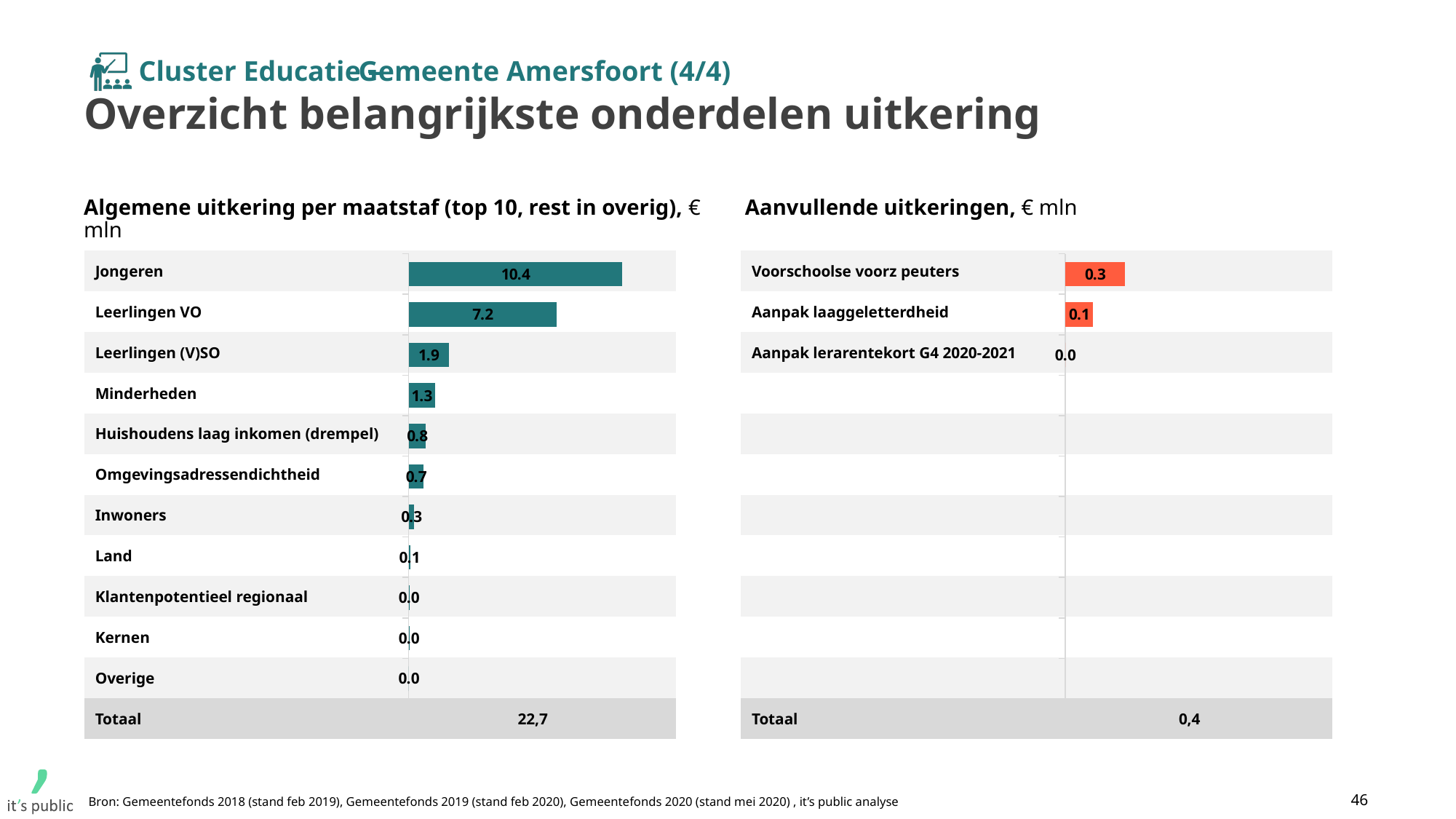
What is the total shown for the 'Aanvullende uitkeringen' chart? 0,4 In the 'Aanvullende uitkeringen' chart, which category has the lowest value? Aanpak lerarentekort G4 2020-2021 In the 'Algemene uitkering per maatstaf' chart, what is the value for Jongeren? 10.4 What is the total shown for the 'Algemene uitkering per maatstaf' chart? 22,7 In the 'Algemene uitkering per maatstaf' chart, what is the value for Minderheden? 1.3 In the 'Algemene uitkering per maatstaf' chart, what is the difference between Jongeren and Leerlingen VO? 3.2 What type of chart is the 'Aanvullende uitkeringen' chart? Bar chart In the 'Algemene uitkering per maatstaf' chart, which is larger: Leerlingen (V)SO or Minderheden? Leerlingen (V)SO How many categories (including Overige, excluding the total row) are shown in the 'Algemene uitkering per maatstaf' chart? 11 In the 'Aanvullende uitkeringen' chart, what is the value for Voorschoolse voorz peuters? 0.3 In the 'Algemene uitkering per maatstaf' chart, what is the value for Leerlingen VO? 7.2 In the 'Algemene uitkering per maatstaf' chart, which category has the highest value? Jongeren